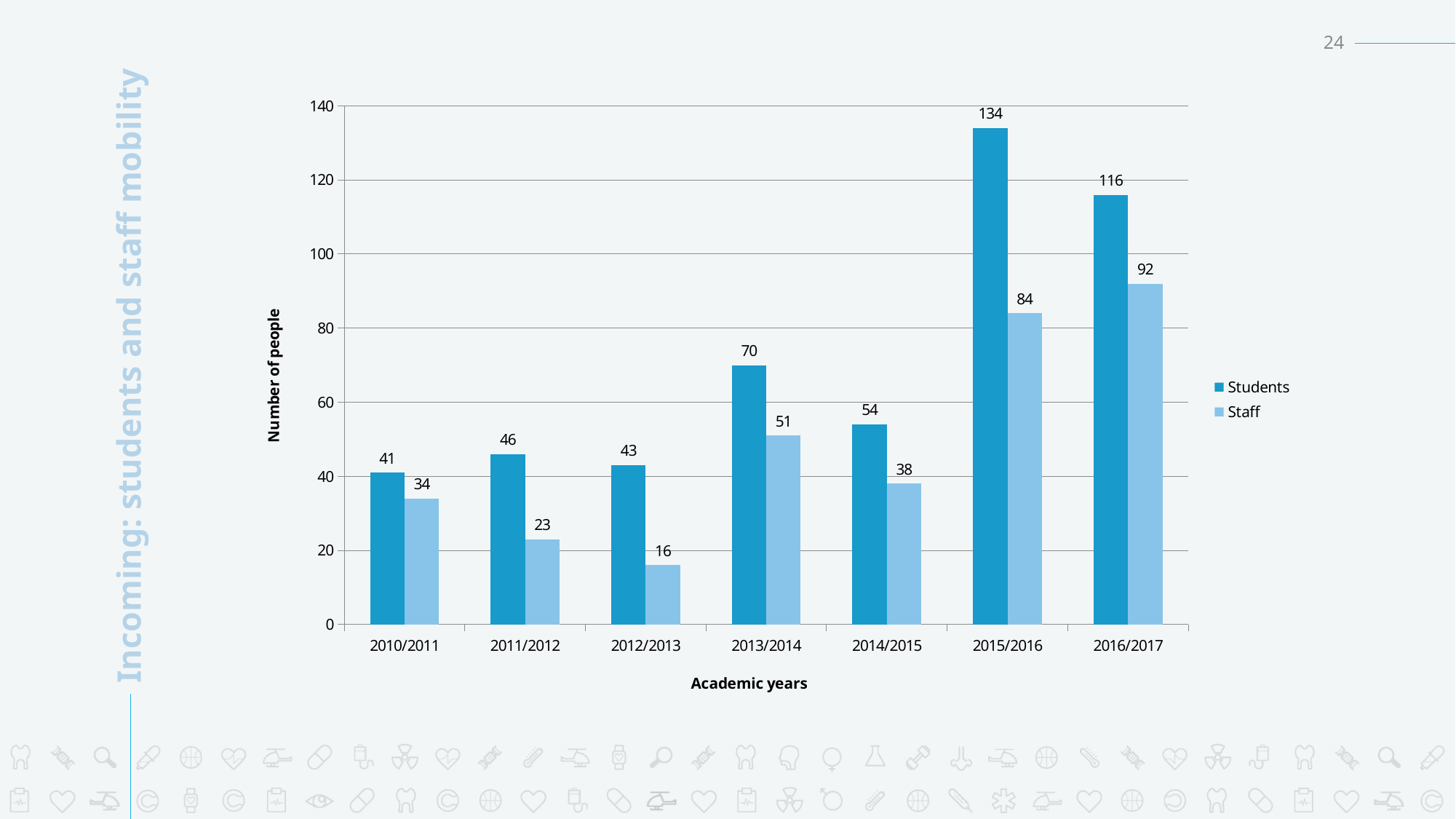
How many Students were recorded in 2015/2016? 134 What is the Staff value for 2016/2017? 92 How many academic years are shown on the x axis? 7 What is the Staff value for 2012/2013? 16 Did the Students value rise or fall from 2015/2016 to 2016/2017? Fall What is the label of the y axis? Number of people Which academic year has the lowest Staff value? 2012/2013 Which is larger in 2013/2014: Students or Staff? Students What kind of chart is shown on the slide? Bar chart What is the difference between Students and Staff in 2015/2016? 50 Which academic year has the highest Students value? 2015/2016 How many series does the legend list? 2